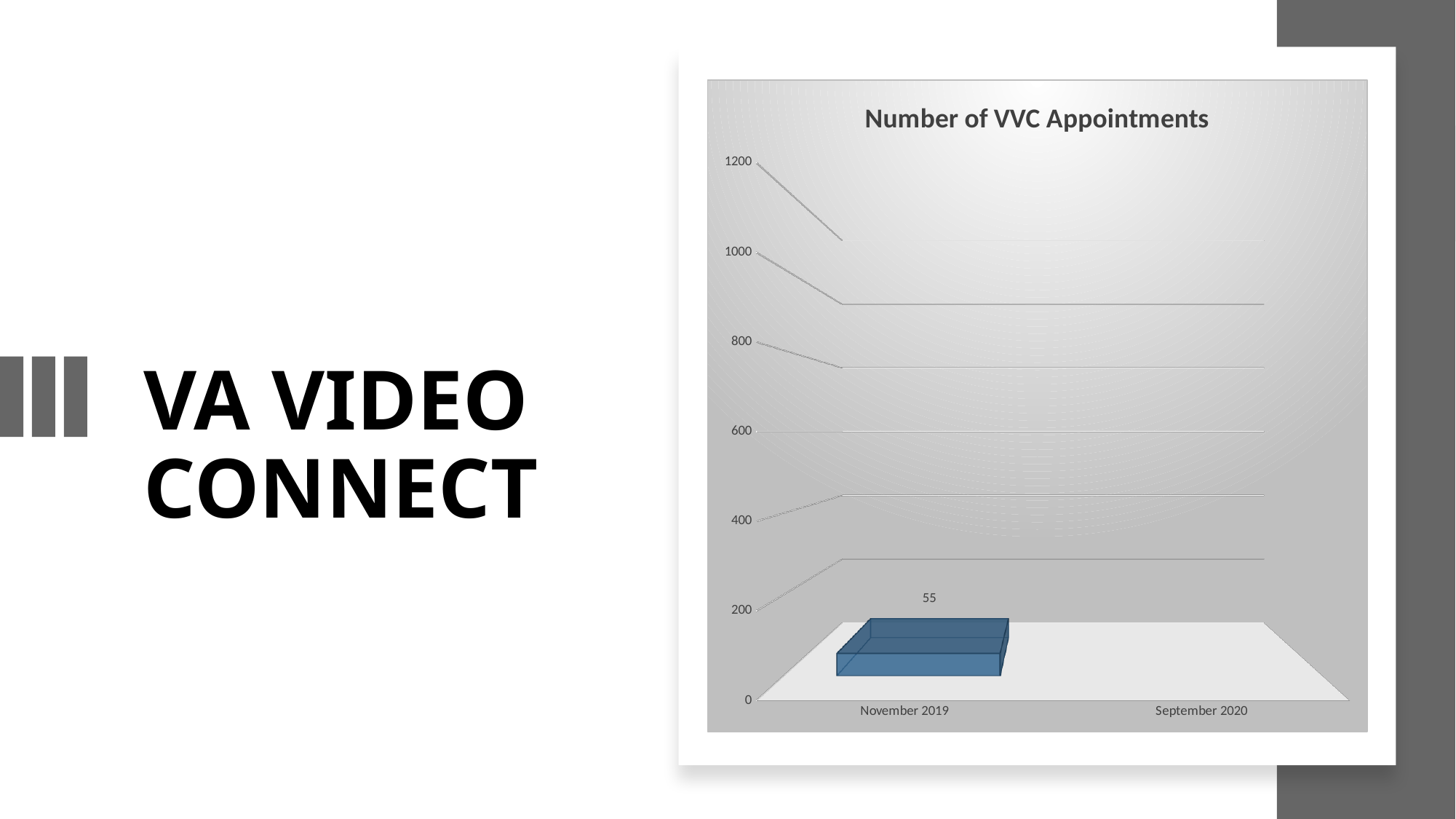
What is the highest value shown on the vertical axis of the chart? 1200 What is the title of the chart? Number of VVC Appointments What is the value for November 2019 in the Number of VVC Appointments chart? 55 What kind of chart is shown on the slide? bar chart Is the value for November 2019 greater or less than 200? less How many categories are labeled on the x axis of the chart? 2 Which category on the x axis has a bar plotted with a data label? November 2019